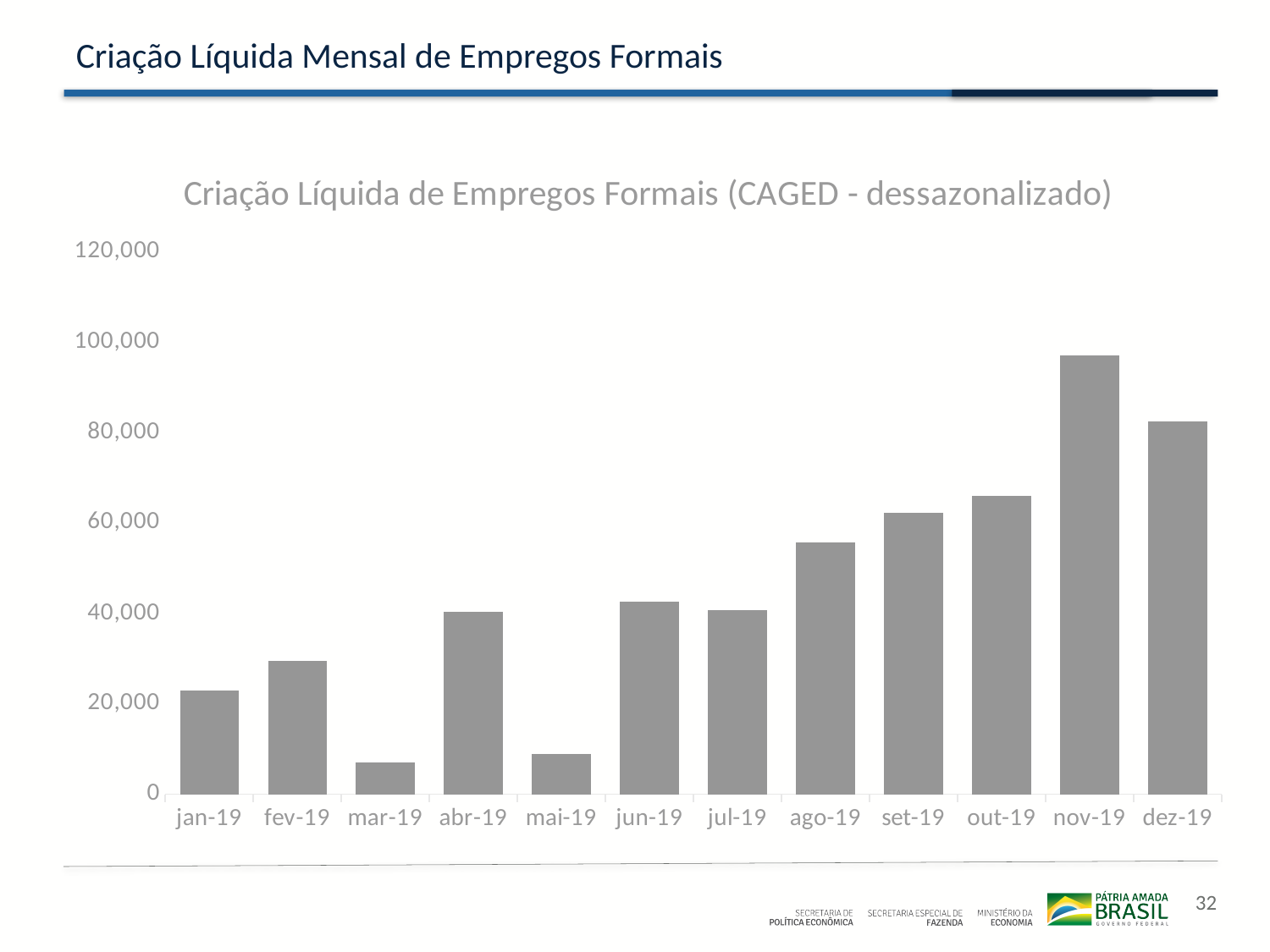
What kind of chart is shown on the slide? bar chart Do the values generally rise or fall from jan-19 to nov-19? rise Is the value for out-19 greater or less than 60,000? greater Which month has the highest value? nov-19 Is the value for fev-19 greater or less than 40,000? less How many months are plotted on the x axis? 12 What is the title of the chart? Criação Líquida de Empregos Formais (CAGED - dessazonalizado) Which is larger, the value for jan-19 or the value for fev-19? fev-19 Which is larger, the value for nov-19 or the value for dez-19? nov-19 Is the value for nov-19 greater or less than 80,000? greater